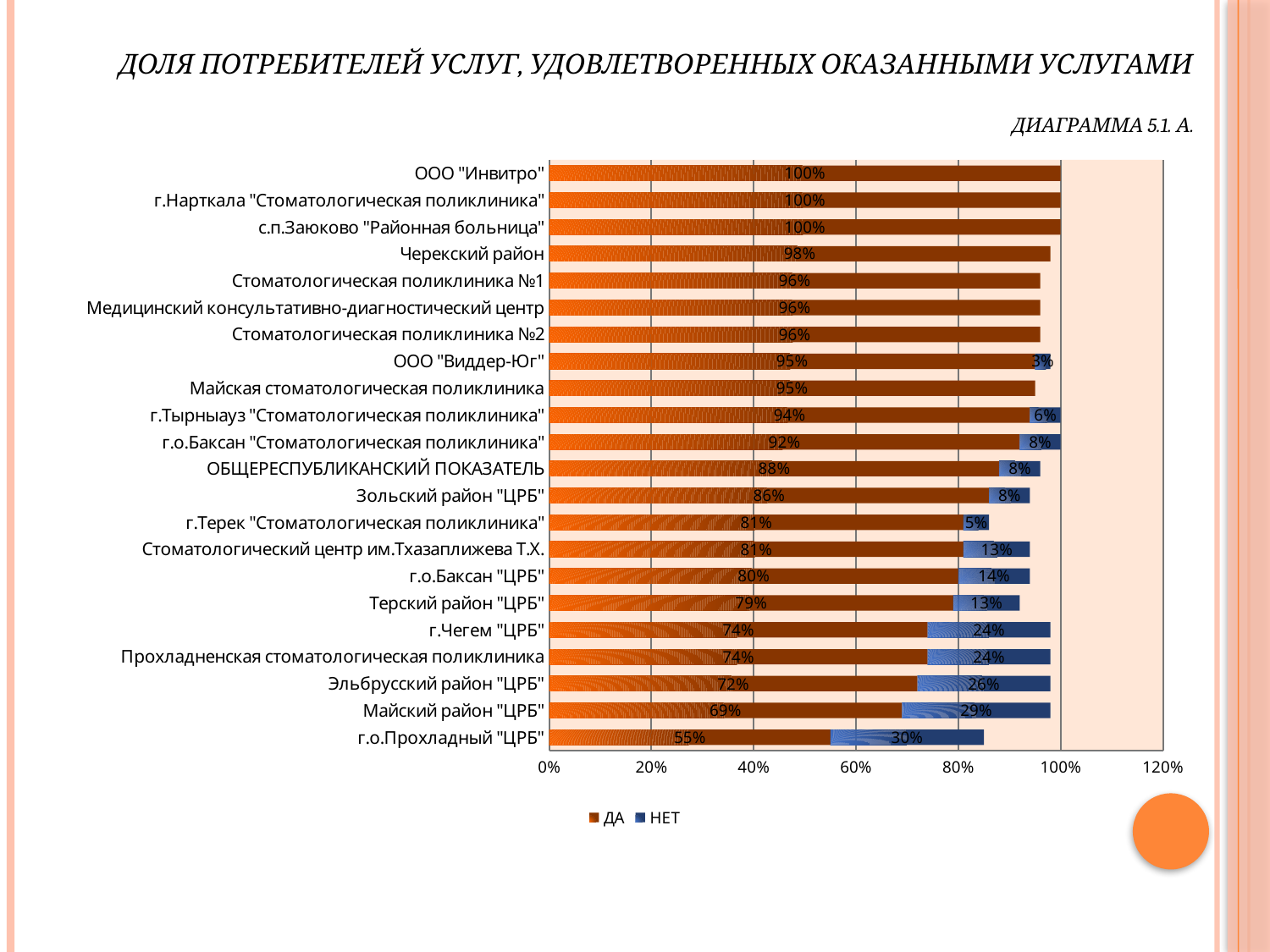
How many categories are shown on the chart? 22 What is the total of the stacked bar for Майский район "ЦРБ"? 98% What is the difference between the ДА values for Зольский район "ЦРБ" and Майский район "ЦРБ"? 17% What is the НЕТ value for Эльбрусский район "ЦРБ"? 26% What is the ДА value for Черекский район? 98% What is the ДА value for ОБЩЕРЕСПУБЛИКАНСКИЙ ПОКАЗАТЕЛЬ? 88% What are the two legend entries of the chart? ДА and НЕТ Which has a larger НЕТ value, г.Чегем "ЦРБ" or Терский район "ЦРБ"? г.Чегем "ЦРБ" Which category has the lowest ДА value? г.о.Прохладный "ЦРБ" Which category has the highest НЕТ value? г.о.Прохладный "ЦРБ" What kind of chart is shown on the slide? Stacked horizontal bar chart How many series does the legend list? 2